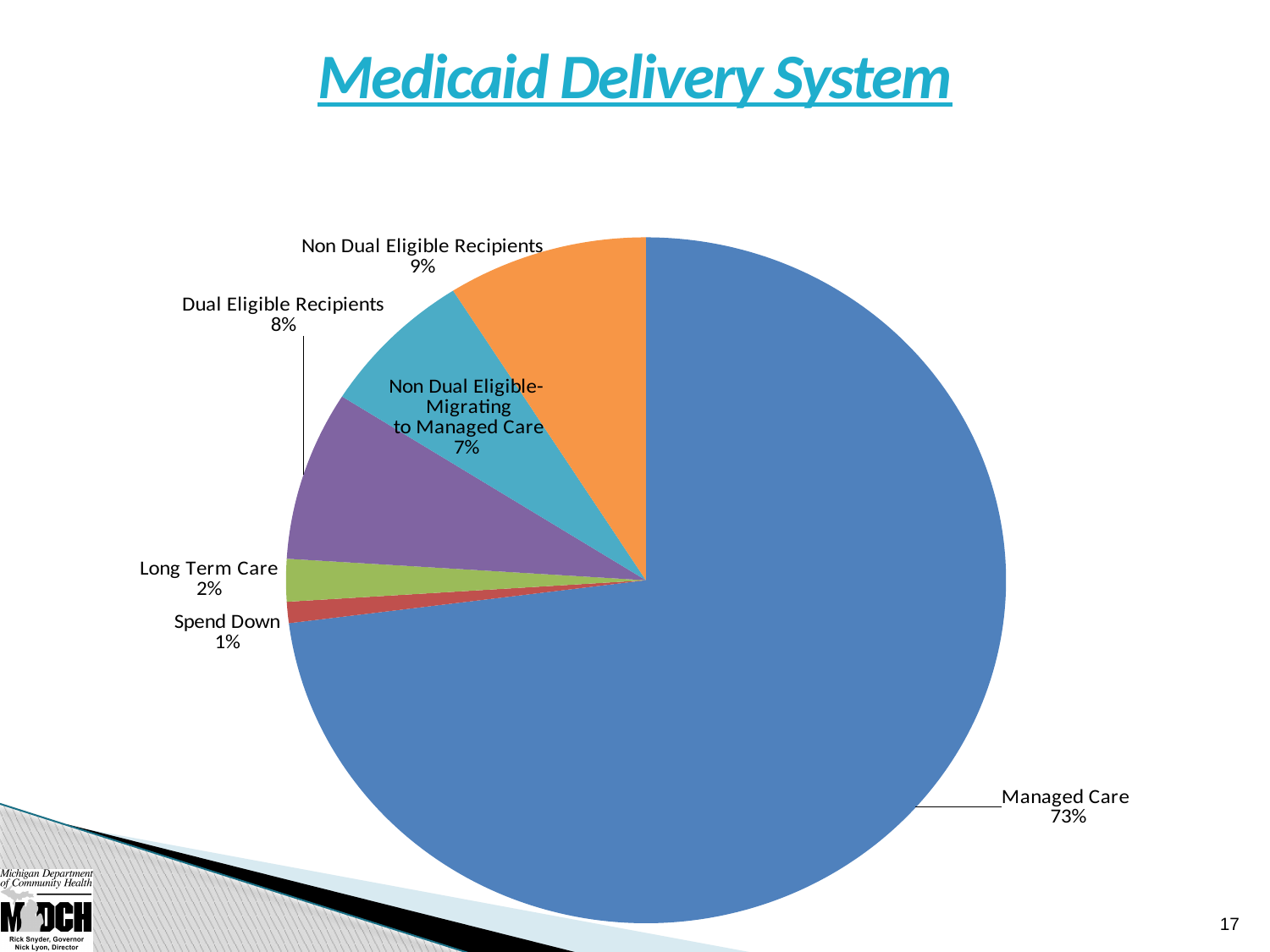
Which category has the smallest slice of the pie? Spend Down What kind of chart is shown on the slide? pie chart Which category has the largest slice of the pie? Managed Care Which is larger, Dual Eligible Recipients or Long Term Care? Dual Eligible Recipients How many categories are shown in the pie chart? 6 What is the value for Dual Eligible Recipients? 8% What is the value for Non Dual Eligible-Migrating to Managed Care? 7% What share of the pie does Managed Care represent? 73% What is the value for Non Dual Eligible Recipients? 9% What is the value for Long Term Care? 2% What is the difference between the Managed Care share and the Non Dual Eligible Recipients share? 64% What is the value for Spend Down? 1%